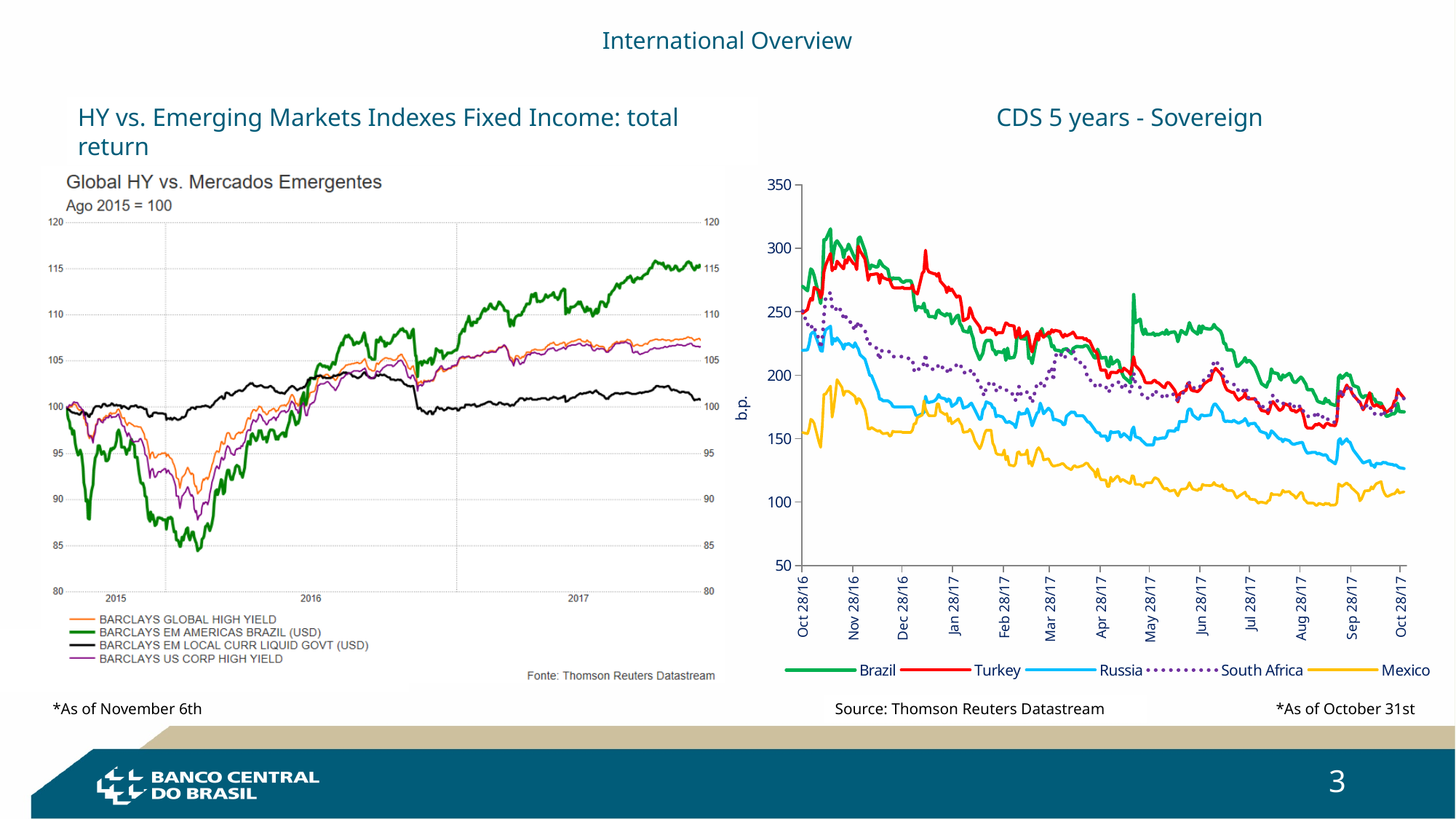
What is the unit shown on the y axis of the 'CDS 5 years - Sovereign' chart? b.p. In the 'CDS 5 years - Sovereign' chart, does the Mexico series rise or fall overall from Oct 28/16 to Oct 28/17? fall What kind of chart is the 'CDS 5 years - Sovereign' chart? line chart In the 'Global HY vs. Mercados Emergentes' chart, which series is the highest at the end of 2017? BARCLAYS EM AMERICAS BRAZIL (USD) How many series does the legend of the 'CDS 5 years - Sovereign' chart list? 5 In the 'CDS 5 years - Sovereign' chart, is the value for Mexico at Oct 28/17 greater or less than 150? less In the 'Global HY vs. Mercados Emergentes' chart, is the value for BARCLAYS EM AMERICAS BRAZIL (USD) at the end of 2017 greater or less than 110? greater In the 'CDS 5 years - Sovereign' chart, which is larger at Oct 28/17: Brazil or Mexico? Brazil In the 'Global HY vs. Mercados Emergentes' chart, does the BARCLAYS EM AMERICAS BRAZIL (USD) series rise or fall from 2016 to 2017? rise In the 'CDS 5 years - Sovereign' chart, which series is the lowest at Oct 28/17? Mexico How many series does the legend of the 'Global HY vs. Mercados Emergentes' chart list? 4 In the 'CDS 5 years - Sovereign' chart, is the value for Russia at Oct 28/17 greater or less than 150? less